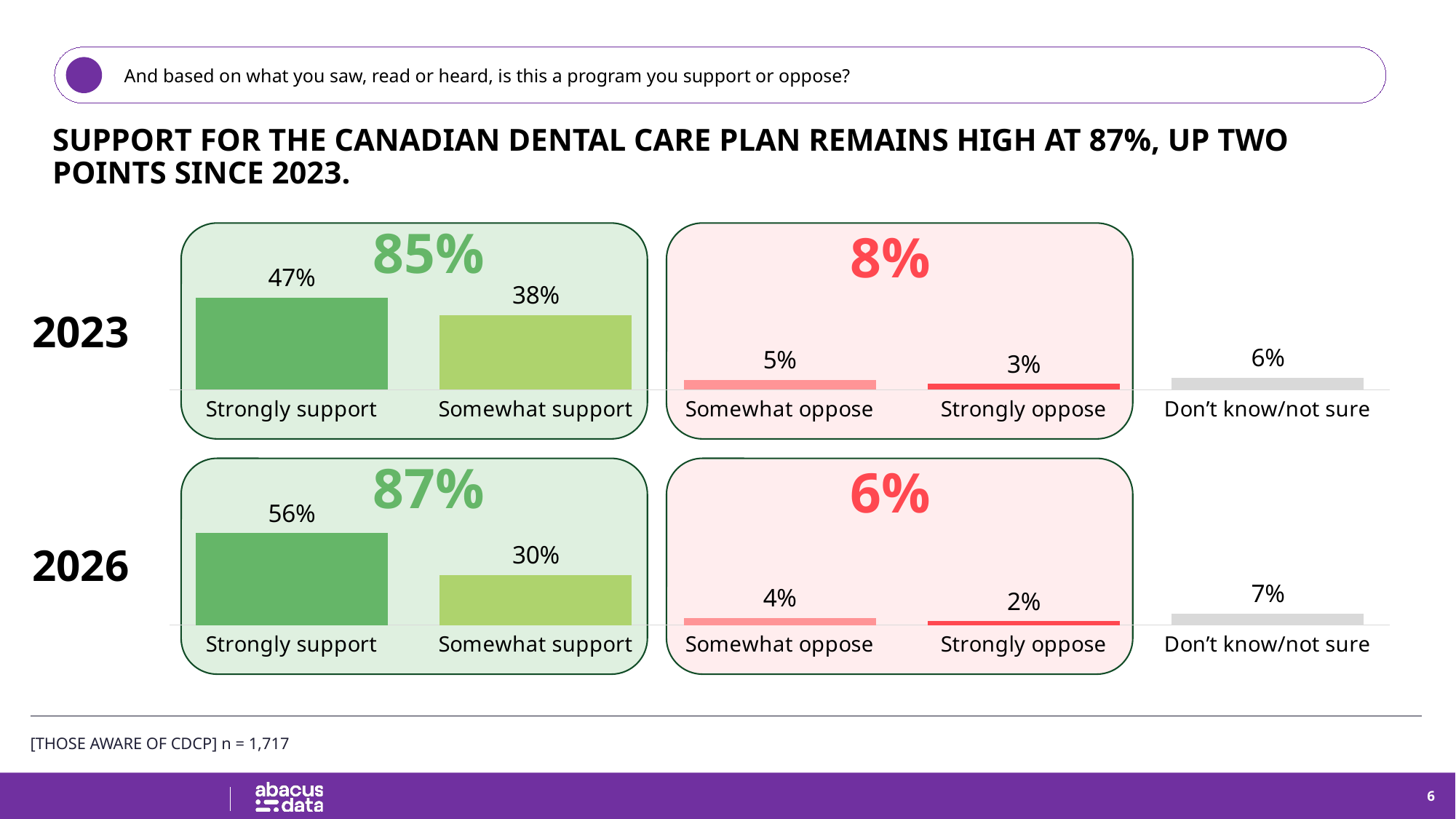
In the 2023 chart, which category has the lowest value? Strongly oppose What is the combined total support (Strongly support plus Somewhat support) shown for 2026? 87% In the 2023 chart, what is the value for Strongly support? 47% In the 2023 chart, what is the value for Strongly oppose? 3% What is the difference between Strongly support in 2026 and Strongly support in 2023? 9 percentage points In the 2026 chart, which category has the highest value? Strongly support What kind of chart is used to show the 2023 results? Bar chart In the 2023 chart, which is larger: Somewhat oppose or Don't know/not sure? Don't know/not sure How many categories are shown in the 2026 chart? 5 What is the combined total oppose (Somewhat oppose plus Strongly oppose) shown for 2023? 8% In the 2026 chart, what is the value for Don't know/not sure? 7% In the 2026 chart, what is the value for Somewhat support? 30%